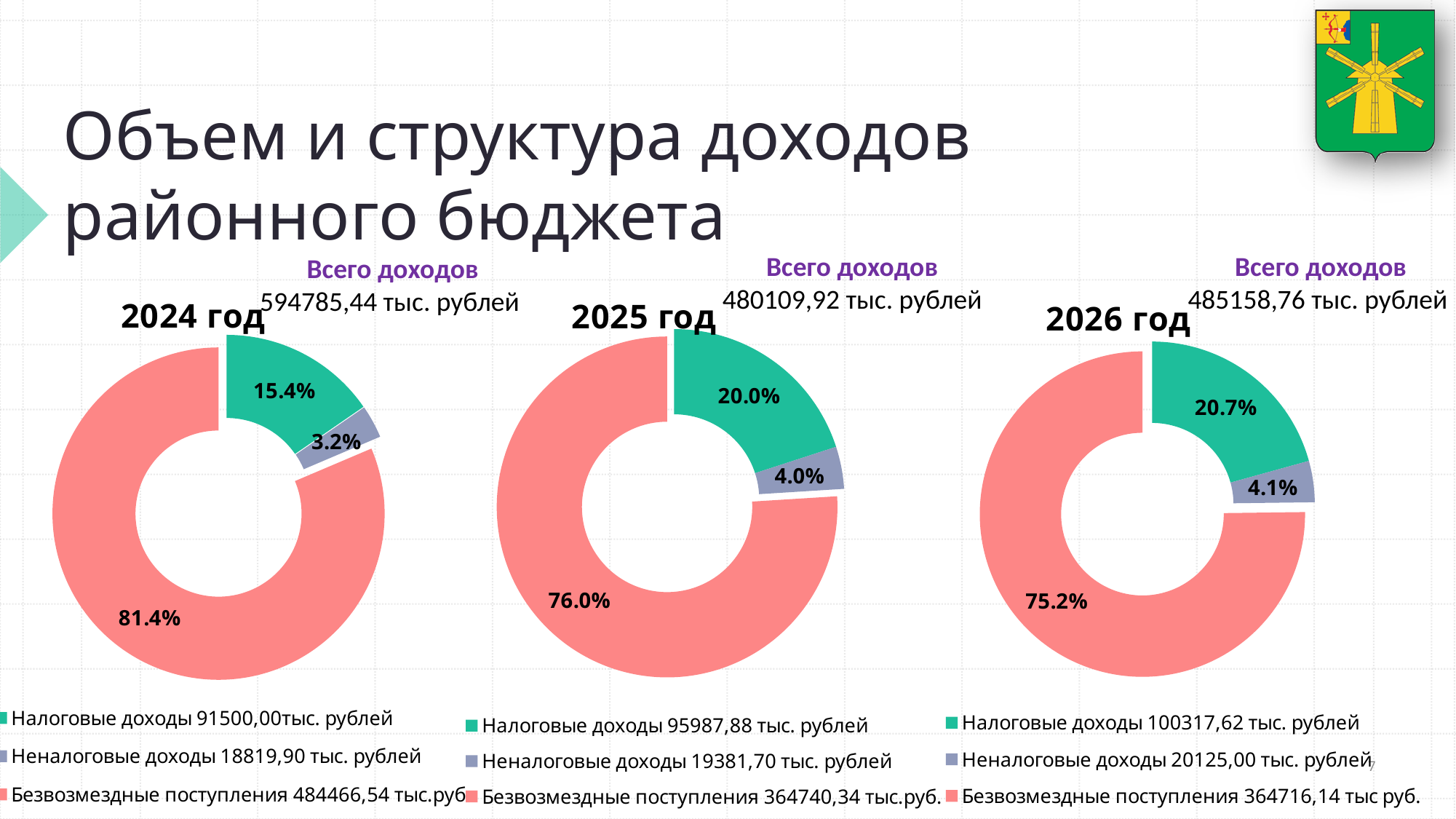
According to the legend of the 2026 год chart, what is the value of Налоговые доходы? 100317,62 тыс. рублей What total revenue (Всего доходов) is shown above the 2025 год chart? 480109,92 тыс. рублей In the 2025 год chart, what percentage is shown for Налоговые доходы? 20.0% In the 2024 год chart, what share of revenue is Безвозмездные поступления? 81.4% How many slices does the 2025 год chart have? 3 In the 2025 год chart, what is the difference in percentage points between Безвозмездные поступления and Налоговые доходы? 56.0 What type of chart is used for 2024 год? Doughnut chart In the 2026 год chart, what percentage is shown for Неналоговые доходы? 4.1% Is the Налоговые доходы share larger in the 2024 год chart or the 2026 год chart? 2026 год In the 2024 год chart, which category has the smallest share? Неналоговые доходы In the 2026 год chart, which category has the largest share? Безвозмездные поступления How many entries does the legend of the 2024 год chart list? 3